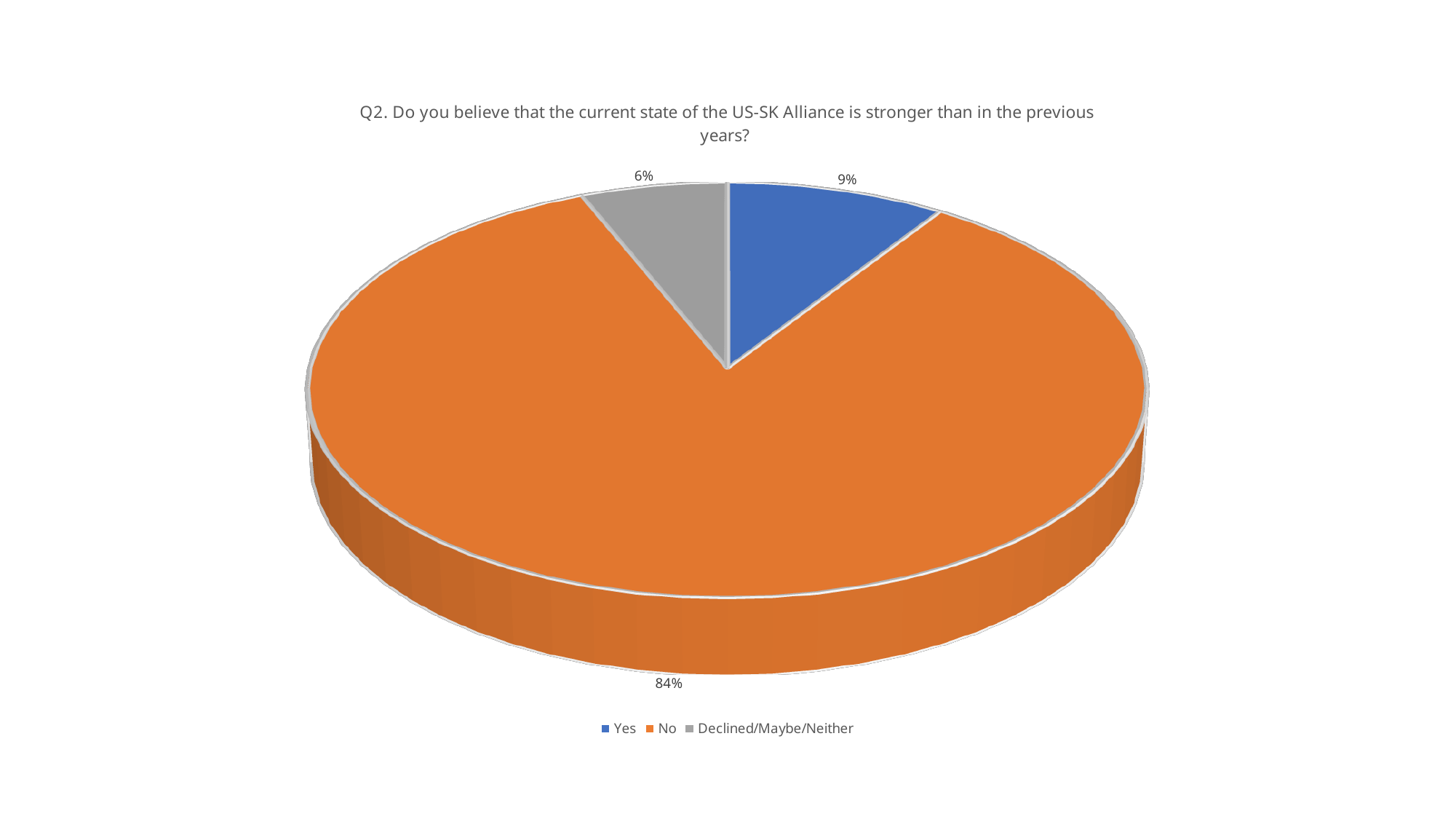
Which response has the largest share of the pie? No How many slices does the pie chart have? 3 What percentage of respondents answered "Yes"? 9% What percentage of respondents answered "No"? 84% Which is larger, the share for "Yes" or the share for "Declined/Maybe/Neither"? Yes What percentage of respondents fall under "Declined/Maybe/Neither"? 6% What kind of chart is shown on the slide? Pie chart Which response has the smallest share of the pie? Declined/Maybe/Neither What colour is the slice representing "No"? Orange What is the difference in percentage points between the "Yes" and "Declined/Maybe/Neither" shares? 3 What is the title of the chart? Q2. Do you believe that the current state of the US-SK Alliance is stronger than in the previous years? What is the difference in percentage points between the "No" and "Yes" shares? 75